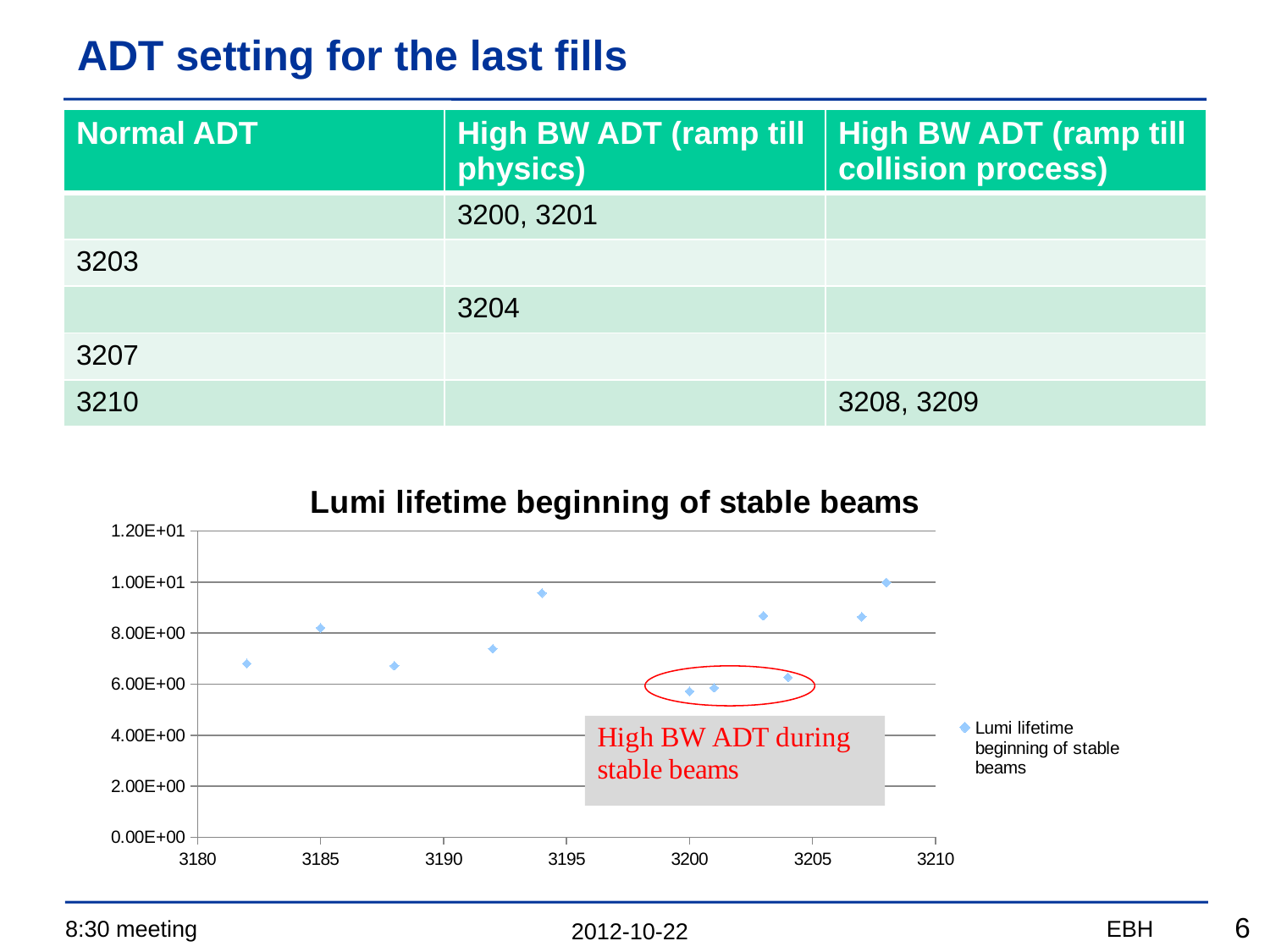
Is the lumi lifetime for fill 3203 greater or less than 8.00E+00? greater Which has the larger lumi lifetime, fill 3203 or fill 3204? 3203 How many data points are plotted in the chart? 11 What kind of chart is shown on the slide? scatter chart Is the lumi lifetime for fill 3194 greater or less than 8.00E+00? greater What text is written in the grey box overlaid on the chart? High BW ADT during stable beams How many series does the chart legend list? 1 Is the lumi lifetime for fill 3200 greater or less than 6.00E+00? less What is the title of the chart on the slide? Lumi lifetime beginning of stable beams Which has the larger lumi lifetime, fill 3194 or fill 3182? 3194 Which fill number has the highest lumi lifetime in the chart? 3208